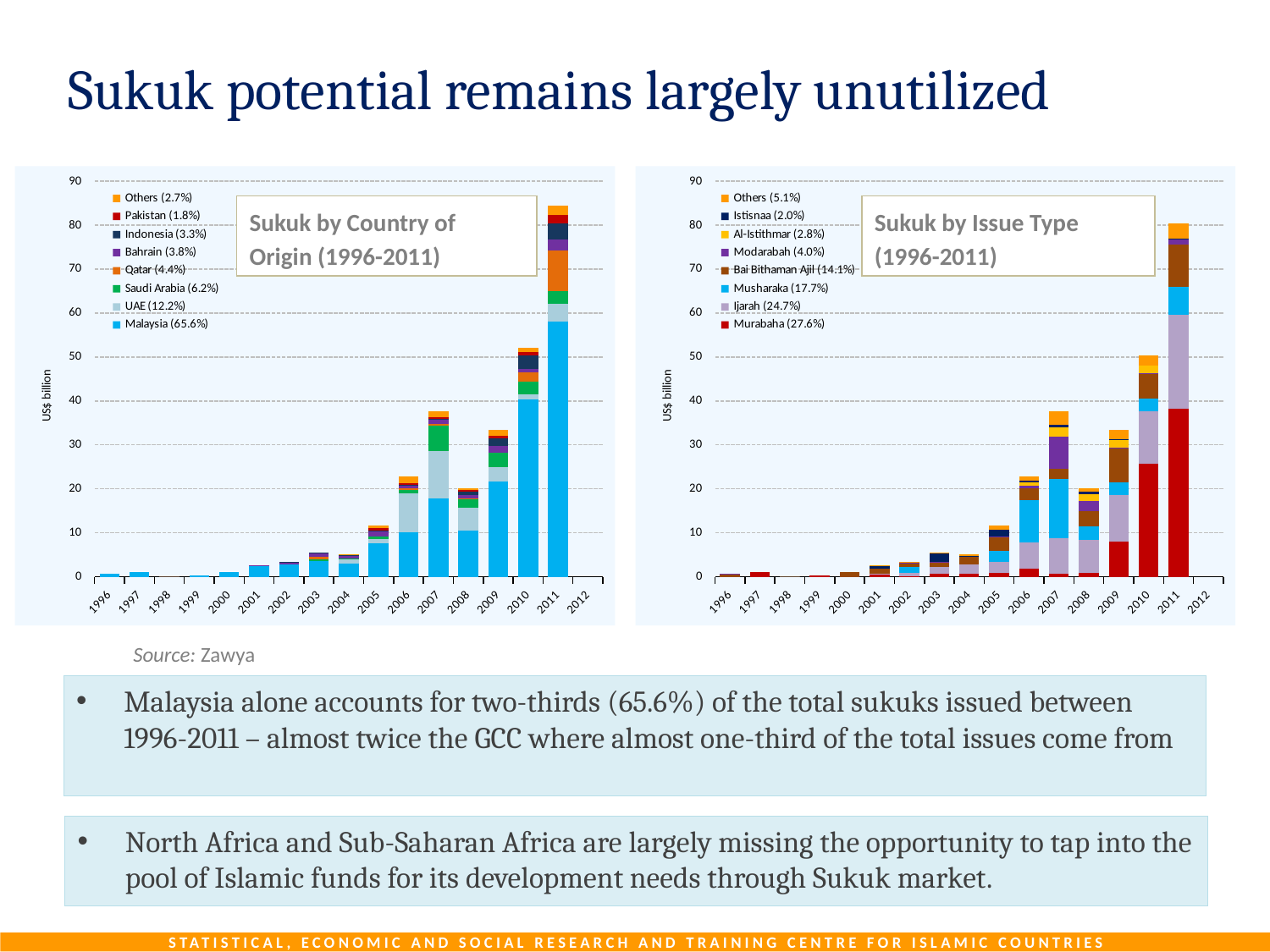
In the 'Sukuk by Country of Origin (1996-2011)' chart, is the total for 2011 greater or less than 80? greater In the 'Sukuk by Country of Origin (1996-2011)' chart, which year has the tallest bar? 2011 What kind of chart is the 'Sukuk by Country of Origin (1996-2011)' chart? Stacked bar chart How many series does the legend of the 'Sukuk by Issue Type (1996-2011)' chart list? 8 In the 'Sukuk by Issue Type (1996-2011)' chart, is the total for 2009 greater or less than 30? greater In the 'Sukuk by Issue Type (1996-2011)' chart, which year has the tallest bar? 2011 In the 'Sukuk by Country of Origin (1996-2011)' chart, do the bar totals generally rise or fall from 1996 to 2011? Rise How many years are shown on the x axis of the 'Sukuk by Country of Origin (1996-2011)' chart? 17 In the 'Sukuk by Country of Origin (1996-2011)' chart, is the total for 2008 greater or less than 30? less According to the legend of the 'Sukuk by Issue Type (1996-2011)' chart, what share does Murabaha account for? 27.6% According to the legend of the 'Sukuk by Country of Origin (1996-2011)' chart, what share does Malaysia account for? 65.6% In the 'Sukuk by Issue Type (1996-2011)' chart, which year has the larger total, 2008 or 2009? 2009